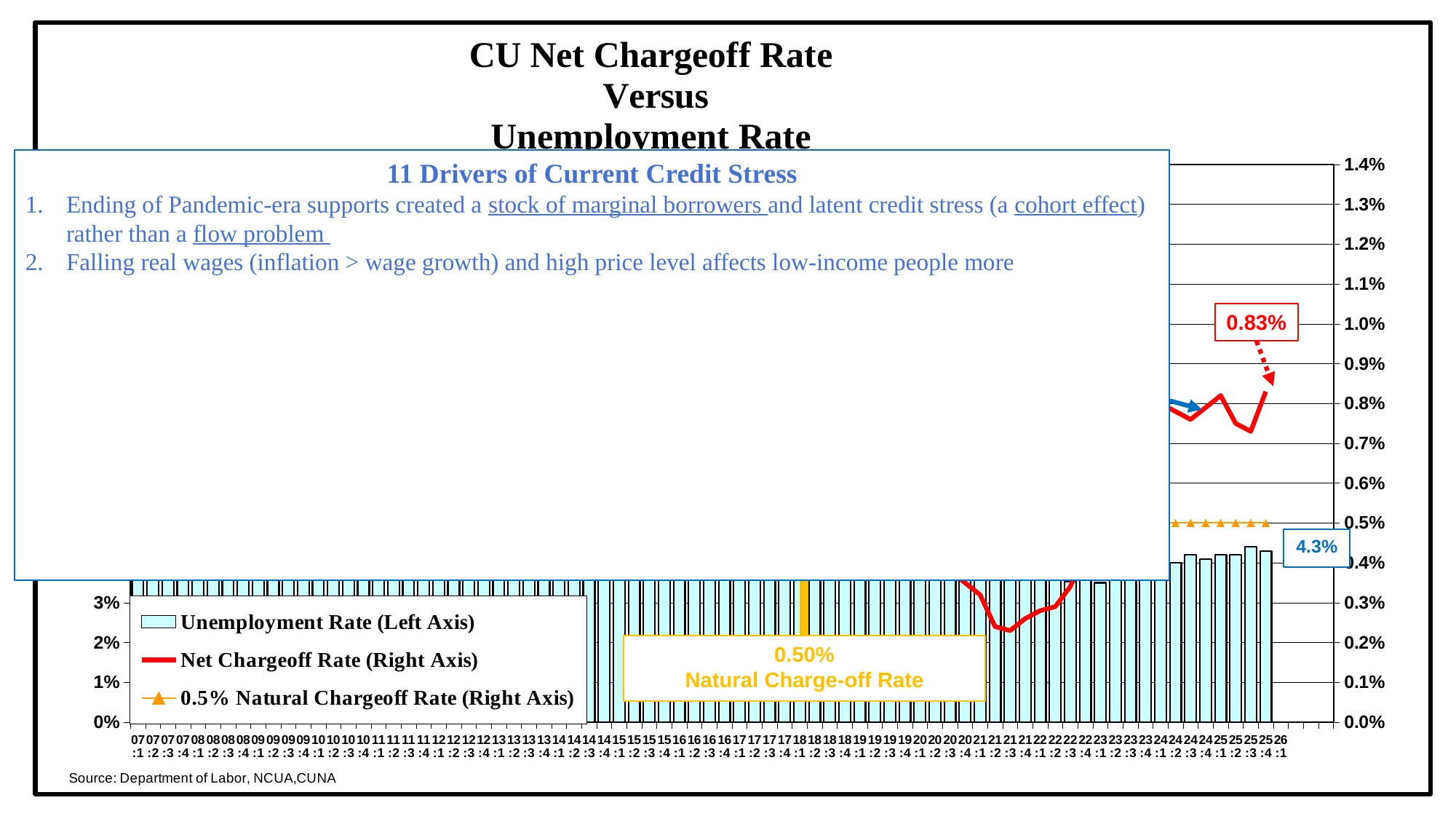
What is the most recent Net Chargeoff Rate value labeled on the chart? 0.83% What is the most recent Unemployment Rate value labeled on the chart? 4.3% What is the highest tick value shown on the right axis? 1.4% What value is given for the Natural Charge-off Rate? 0.50% How many series does the chart legend list? 3 Does the Net Chargeoff Rate rise or fall from its 2021 low point through 2022? rise What colour is the Net Chargeoff Rate line in the legend? Red Is the labeled Net Chargeoff Rate of 0.83% greater or less than the 0.50% Natural Charge-off Rate? greater Is the Net Chargeoff Rate at its low point in 2021 greater or less than 0.3%? less What is the difference between the labeled Net Chargeoff Rate (0.83%) and the Natural Charge-off Rate (0.50%)? 0.33% What is the title of the chart? CU Net Chargeoff Rate Versus Unemployment Rate What kind of chart is this? Combined bar and line chart